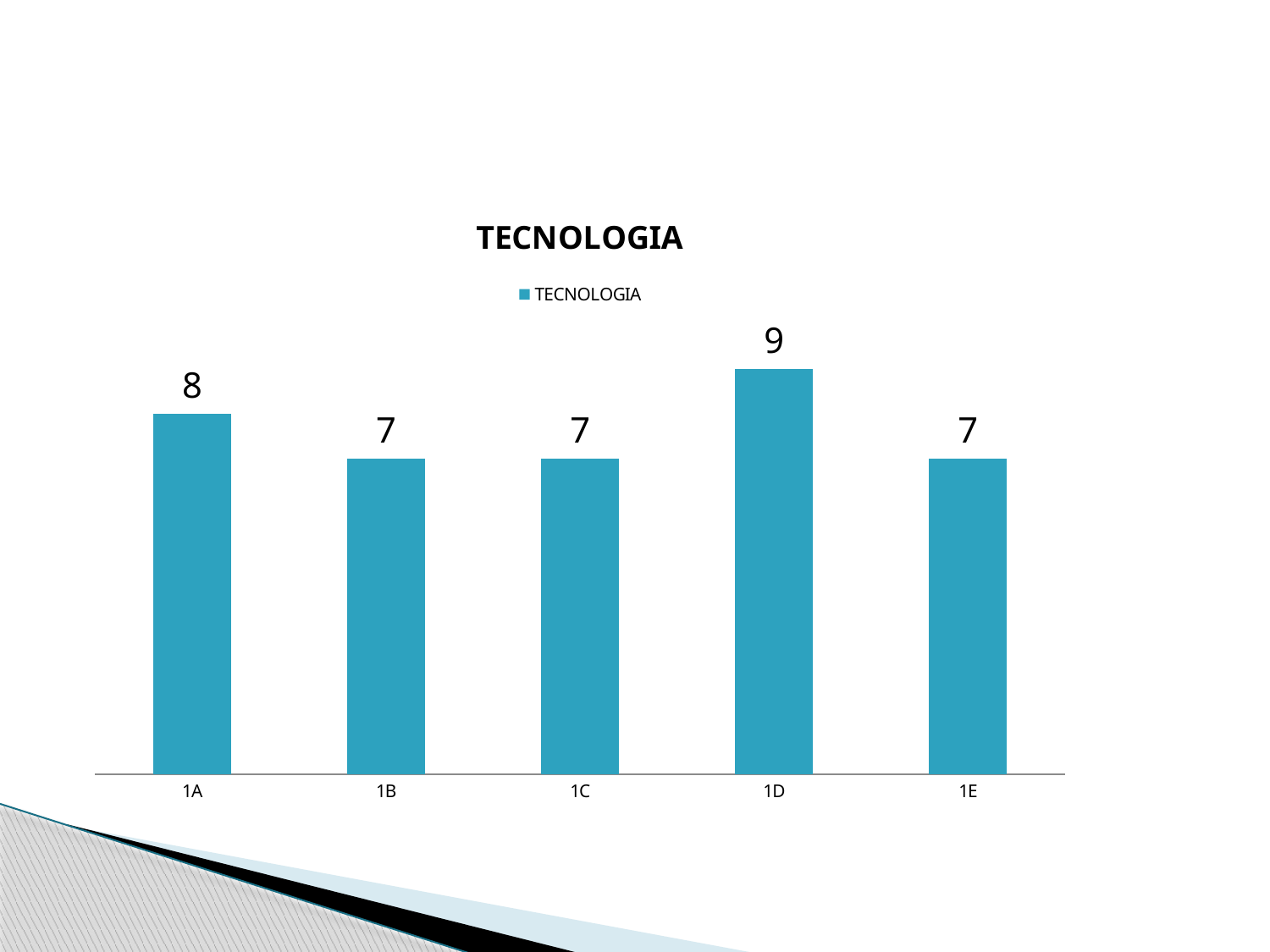
What is the value for 1B? 7 Which is larger, the value for 1A or the value for 1B? 1A Which category has the highest value? 1D What is the value for 1D? 9 What is the title of the chart? TECNOLOGIA What kind of chart is shown? bar chart What is the value for 1E? 7 What is the difference between the values for 1D and 1A? 1 How many categories are shown on the x axis? 5 What is the difference between the values for 1D and 1C? 2 How many series does the legend list? 1 What is the value for 1A? 8